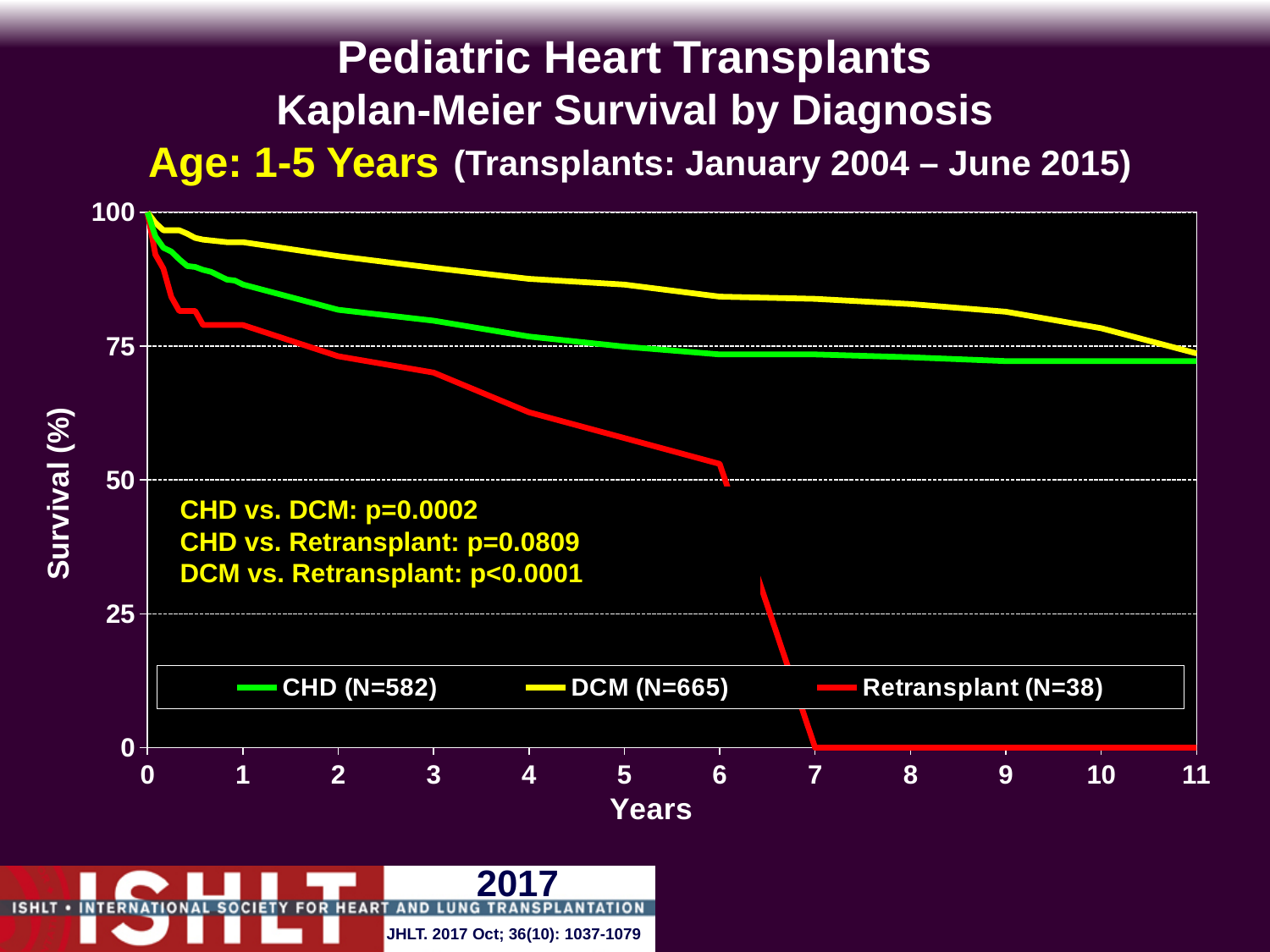
At 3 years, which series has higher survival, CHD or Retransplant? CHD Do the survival curves rise or fall as years increase? fall Is the survival for Retransplant at 5 years greater or less than 50? greater Is the survival for CHD at 10 years greater or less than 75? less Is the survival for Retransplant at 3 years greater or less than 75? less What kind of chart is shown on the slide? line chart Which series has the lowest survival at 6 years? Retransplant Which series has the highest survival at 6 years? DCM What is the survival for Retransplant at 8 years? 0 What is the N for the DCM series in the legend? 665 How many series does the legend list? 3